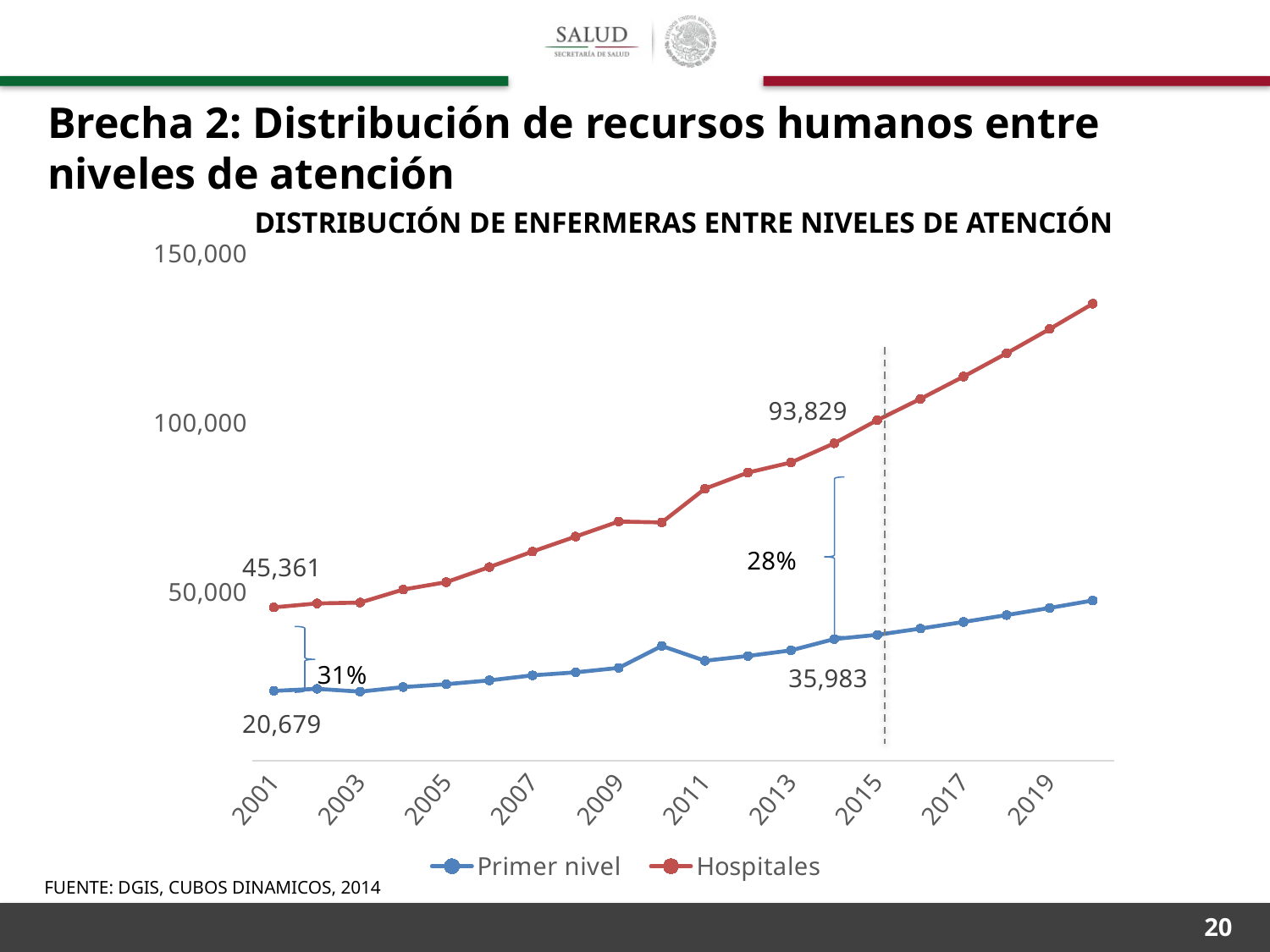
What value is labeled on the Hospitales line just before the dashed vertical line? 93,829 What is the difference between the labeled 2001 values for Hospitales and Primer nivel? 24,682 How many series does the legend list? 2 What is the title of the chart? DISTRIBUCIÓN DE ENFERMERAS ENTRE NIVELES DE ATENCIÓN What value is labeled on the Primer nivel line just before the dashed vertical line? 35,983 What is the labeled value for Primer nivel in 2001? 20,679 What are the two series named in the legend? Primer nivel and Hospitales Which series has the higher value in 2019, Primer nivel or Hospitales? Hospitales Is the value for Primer nivel in 2019 greater or less than 50,000? less What is the labeled value for Hospitales in 2001? 45,361 What kind of chart is shown on the slide? line chart Is the value for Hospitales in 2019 greater or less than 100,000? greater